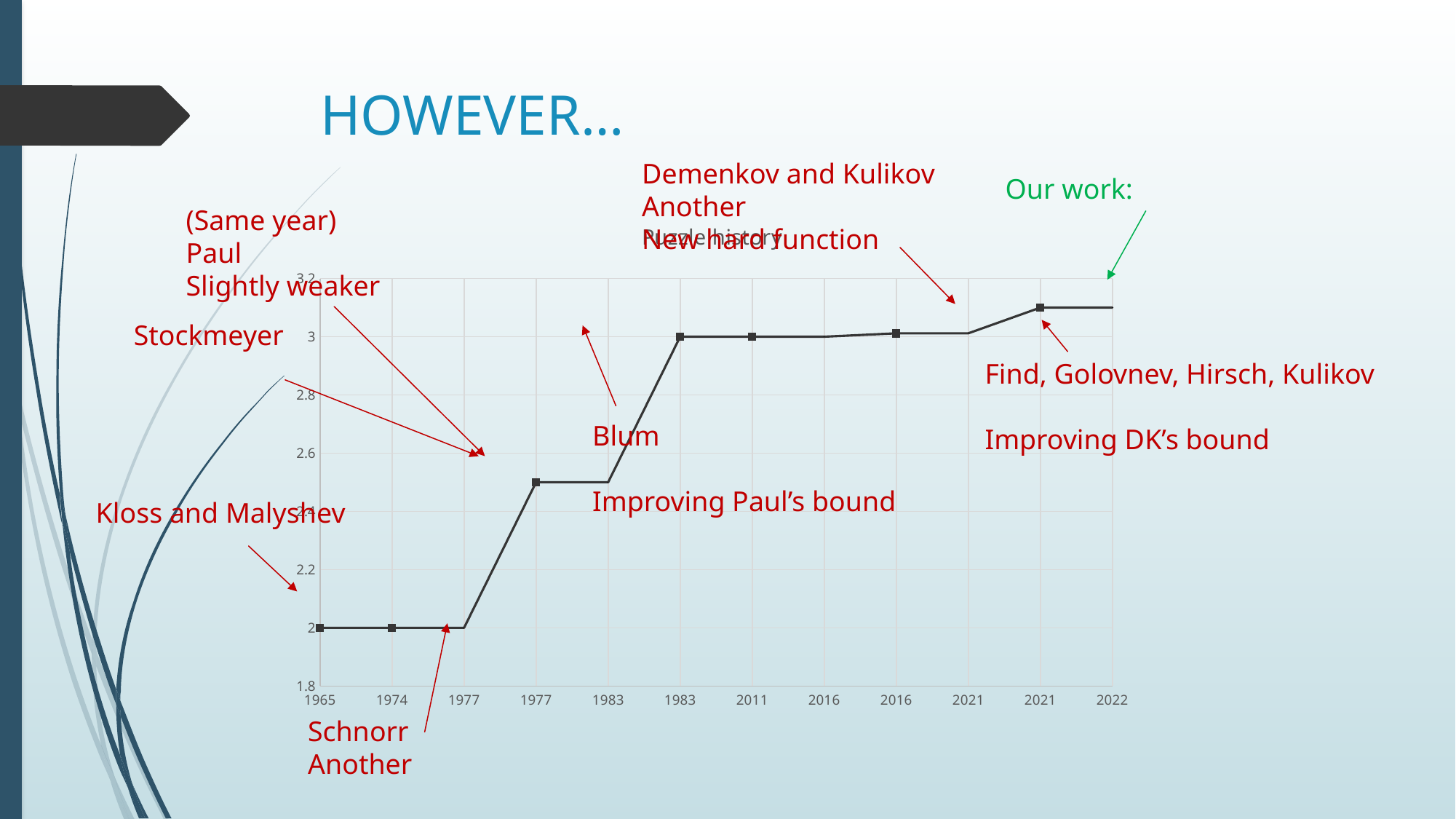
Which has the larger value, the point labelled 1965 or the point labelled 2011? 2011 What is the value plotted for the first point, labelled 1965? 2 What is the lowest value plotted on the line? 2 What kind of chart is shown on the slide? line chart Which annotation on the slide is written in green and points to the last data point? Our work: Is the value for the second point labelled 1977 greater or less than 2.4? greater What is the value plotted for the point labelled 2011? 3 Do the plotted values generally rise or fall from left to right along the x axis? rise Is the value for 2022 greater or less than 3? greater What is the difference between the value at 2011 and the value at 1965? 1 How many data points are plotted on the line? 12 Is the value for 1974 greater or less than 2.2? less